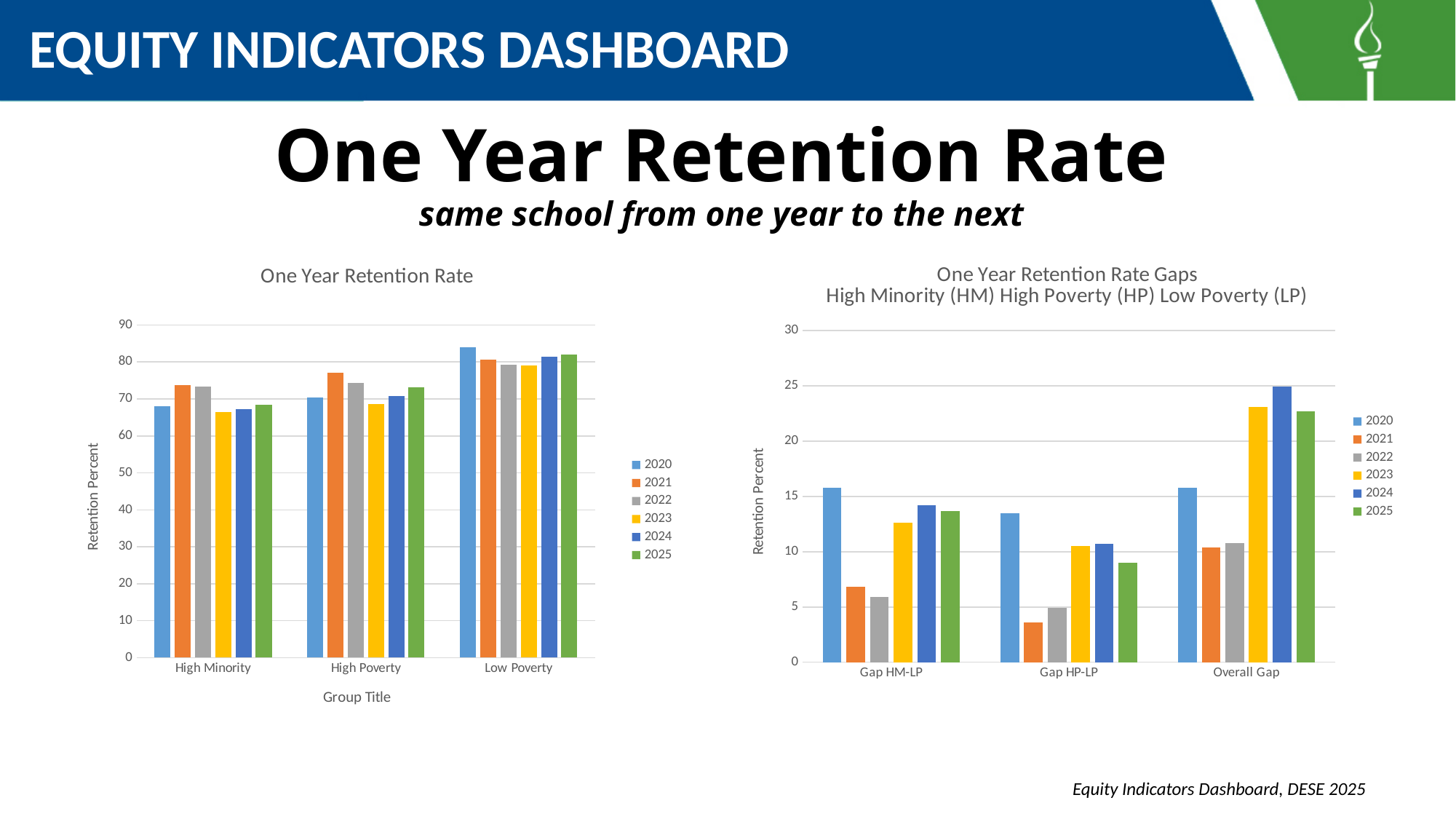
In the 'One Year Retention Rate Gaps' chart on the right, which year has the highest Overall Gap? 2024 In the 'One Year Retention Rate' chart on the left, for High Minority, which is larger: the 2021 value or the 2023 value? 2021 In the 'One Year Retention Rate Gaps' chart on the right, what is the label on the vertical axis? Retention Percent In the 'One Year Retention Rate' chart on the left, is the 2020 value for Low Poverty greater or less than 80? greater In the 'One Year Retention Rate' chart on the left, how many series does the legend list? 6 In the 'One Year Retention Rate' chart on the left, which group has the highest 2020 retention rate? Low Poverty In the 'One Year Retention Rate' chart on the left, is the 2023 value for High Minority greater or less than 70? less In the 'One Year Retention Rate' chart on the left, how many groups are shown on the x axis? 3 In the 'One Year Retention Rate Gaps' chart on the right, which category has the lowest 2021 value? Gap HP-LP In the 'One Year Retention Rate Gaps' chart on the right, is the 2024 value for Overall Gap greater or less than 20? greater In the 'One Year Retention Rate Gaps' chart on the right, how many gap categories are shown on the x axis? 3 In the 'One Year Retention Rate' chart on the left, what kind of chart is it? bar chart